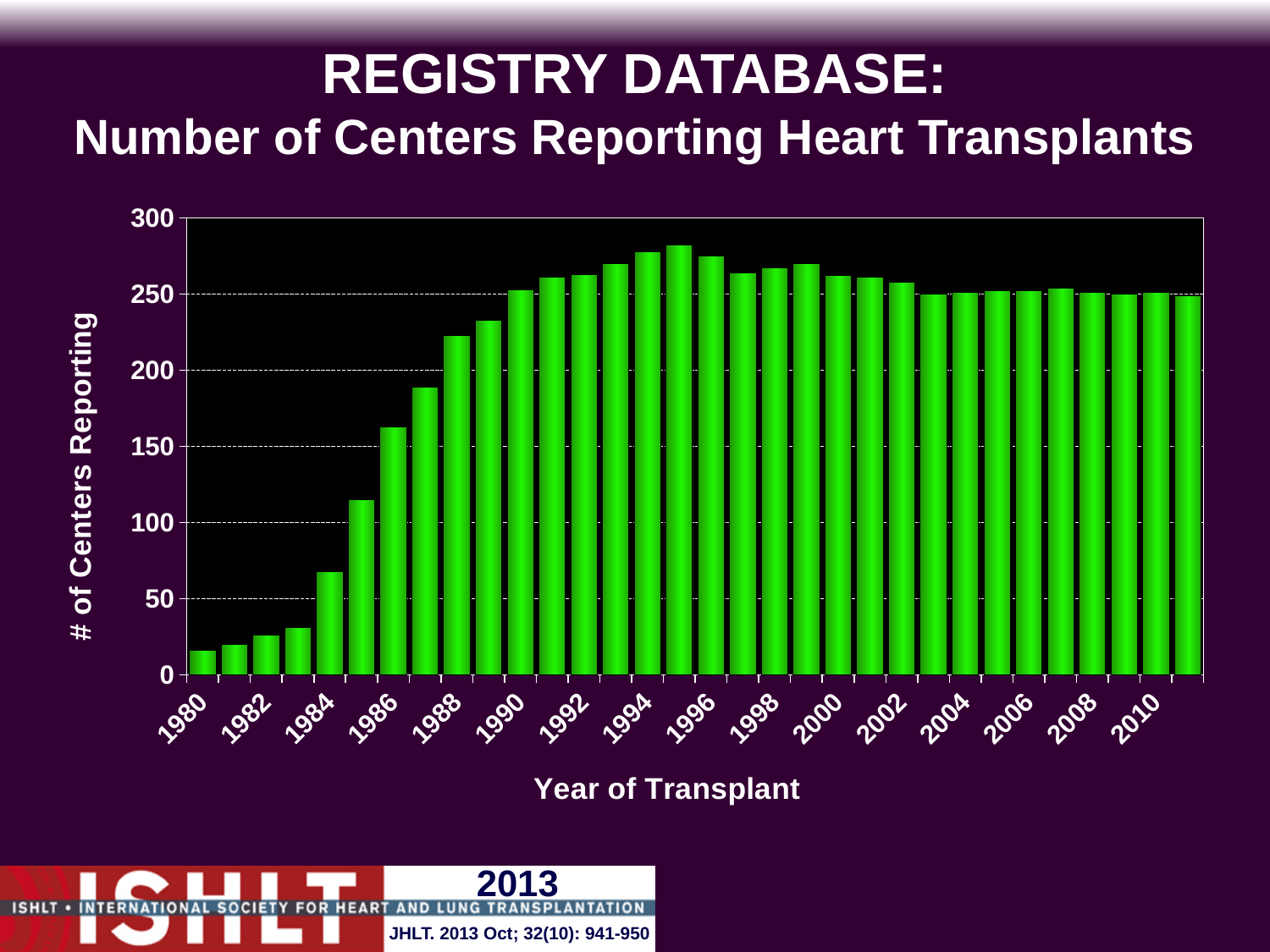
Which year has the highest number of centers reporting? 1995 Is the number of centers reporting in 1995 greater or less than 300? less Which year has more centers reporting, 1986 or 1987? 1987 Is the number of centers reporting in 1987 greater or less than 200? less Do the values rise or fall from 1980 to 1988? rise Is the number of centers reporting in 1983 greater or less than 50? less What is the label of the y axis? # of Centers Reporting What is the label of the x axis? Year of Transplant What kind of chart is shown on the slide? bar chart Which year has the lowest number of centers reporting? 1980